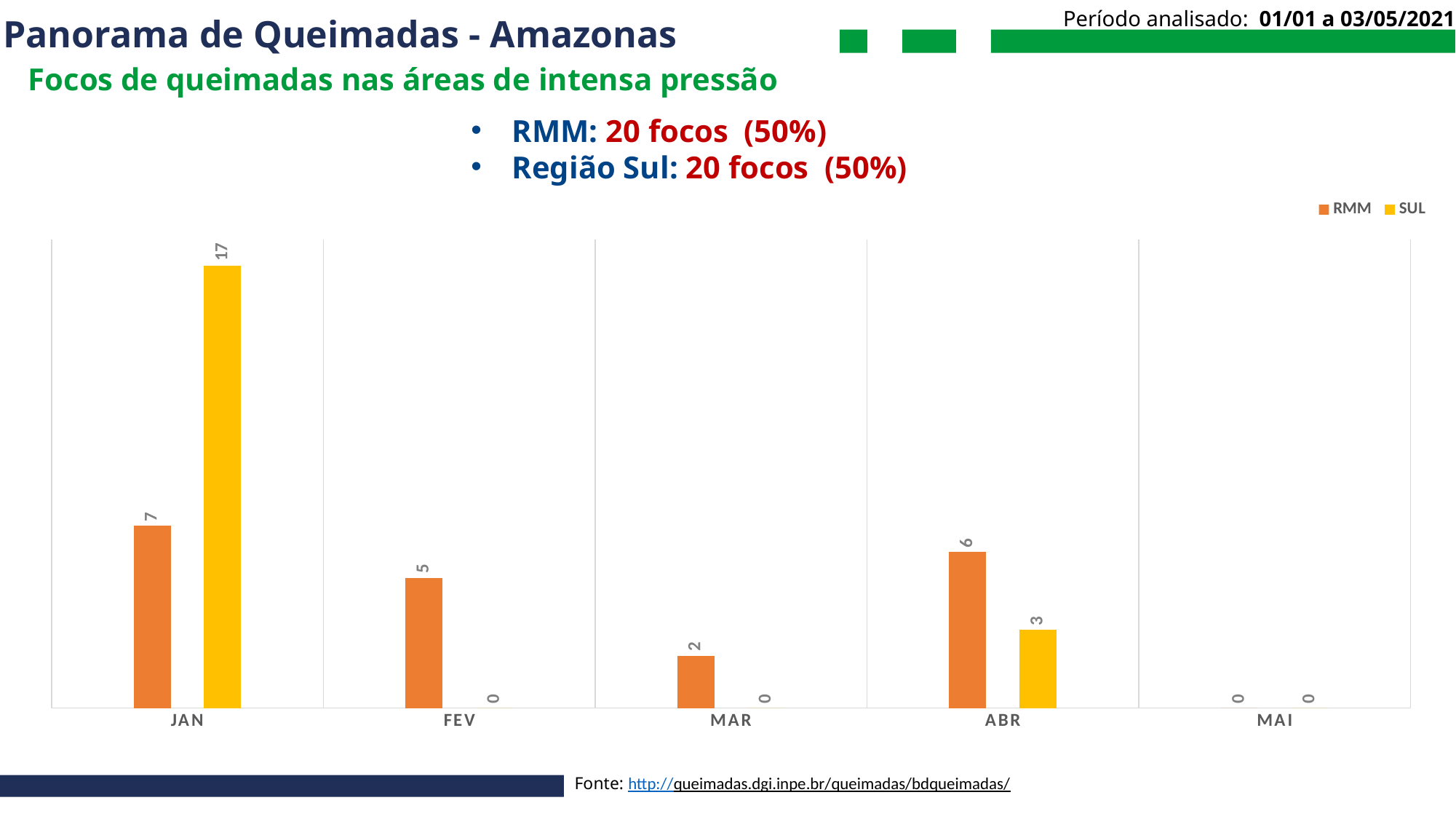
What is the SUL value for JAN? 17 What is the RMM value for ABR? 6 What is the SUL value for FEV? 0 What is the SUL value for ABR? 3 Which month has the lowest RMM value? MAI How many series does the legend list? 2 Which is larger, the RMM value for FEV or the RMM value for MAR? RMM value for FEV What is the RMM value for JAN? 7 What is the difference between the SUL and RMM values for JAN? 10 How many months are shown on the x axis? 5 Which month has the highest RMM value? JAN What kind of chart is shown on the slide? Bar chart